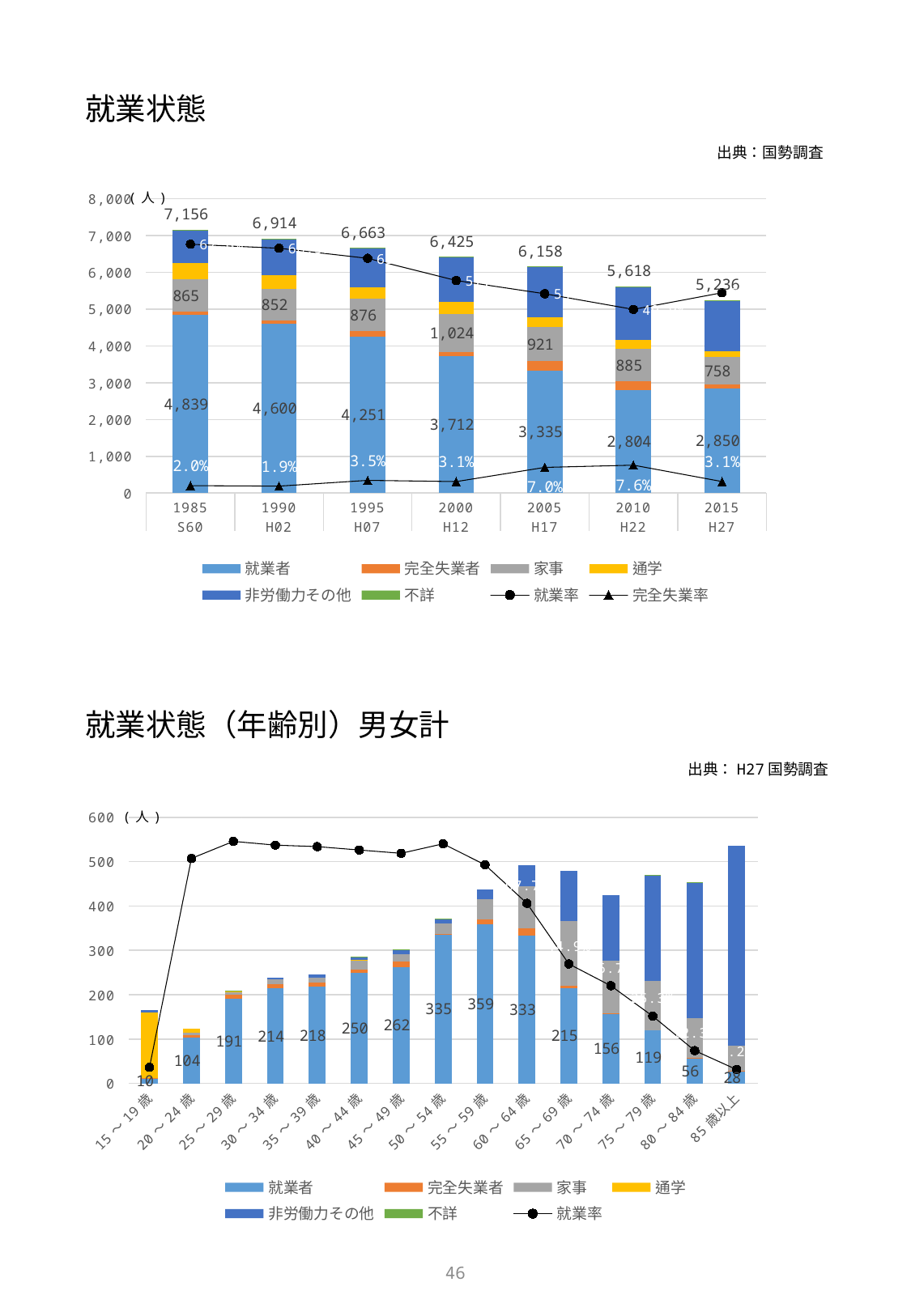
In the bottom chart titled 就業状態（年齢別）男女計, what is the 就業者 value for 55～59歳? 359 In the top chart titled 就業状態, do the bar totals rise or fall from 1985 to 2015? fall In the top chart titled 就業状態, what is the 家事 value for 2005 (H17)? 921 In the top chart titled 就業状態, what is the 完全失業率 value shown for 2010 (H22)? 7.6% In the top chart titled 就業状態, how many entries does the legend list? 8 In the top chart titled 就業状態, which year has the lowest bar total? 2015 (H27) In the bottom chart titled 就業状態（年齢別）男女計, is the 就業者 value for 40～44歳 or 65～69歳 larger? 40～44歳 In the bottom chart titled 就業状態（年齢別）男女計, which age group has the highest 就業者 value? 55～59歳 In the top chart titled 就業状態, what is the 就業者 value for 2000 (H12)? 3,712 In the top chart titled 就業状態, what is the difference between the 就業者 values for 1985 and 1990? 239 In the top chart titled 就業状態, what is the total labelled above the bar for 1985 (S60)? 7,156 In the bottom chart titled 就業状態（年齢別）男女計, how many age groups are shown on the x axis? 15